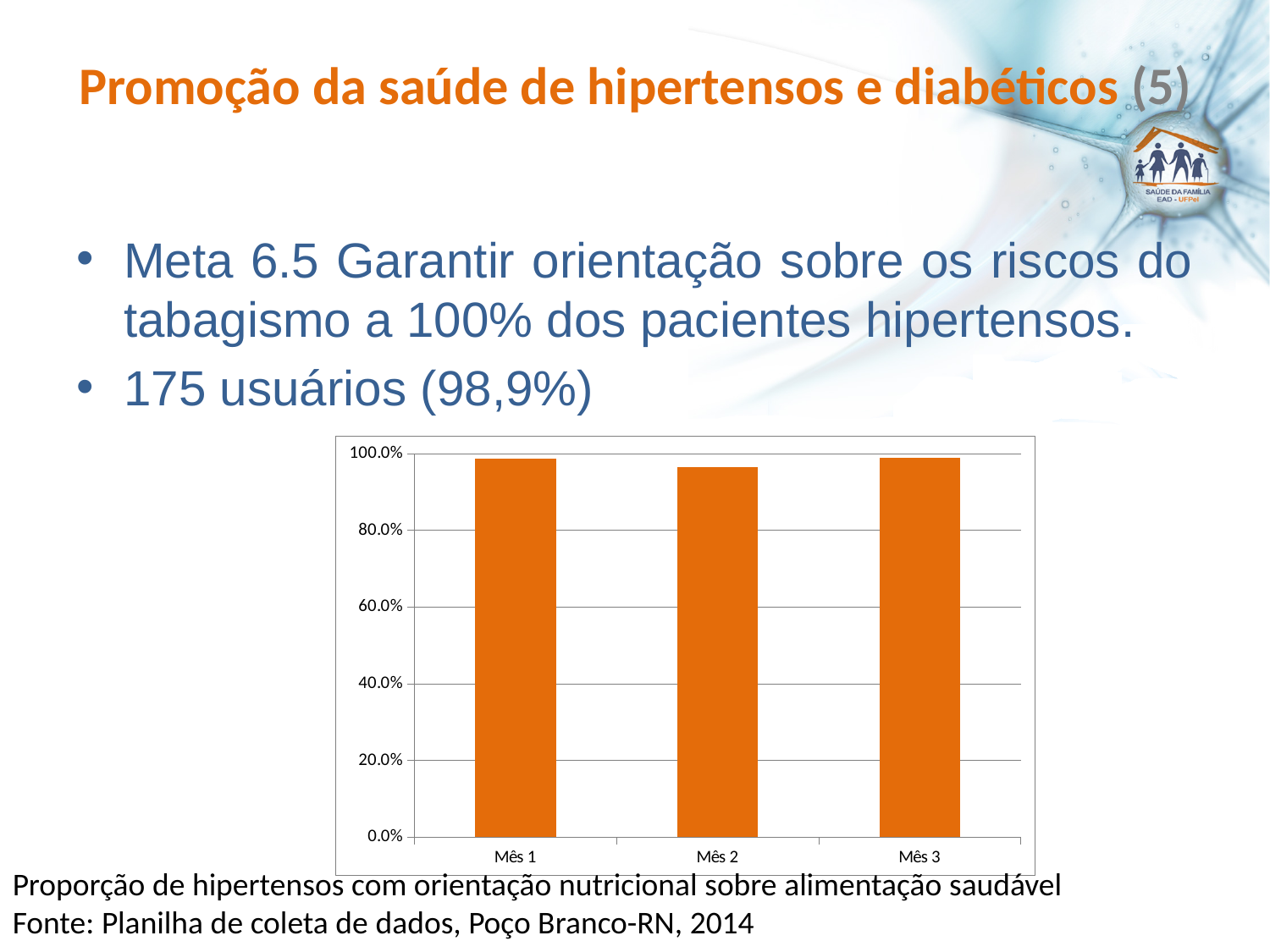
Is the value for Mês 2 greater or less than 80.0%? greater What is the highest tick value shown on the vertical axis of the chart? 100.0% Is the value for Mês 3 greater or less than 60.0%? greater Which is larger, the value for Mês 2 or the value for Mês 3? Mês 3 Which month has the lowest bar on the chart? Mês 2 What colour are the bars in the chart? Orange Does the value fall or rise from Mês 1 to Mês 2? fall Which is larger, the value for Mês 1 or the value for Mês 2? Mês 1 Is the value for Mês 1 greater or less than 80.0%? greater What kind of chart is shown on the slide? Bar chart How many categories (months) are plotted on the chart? 3